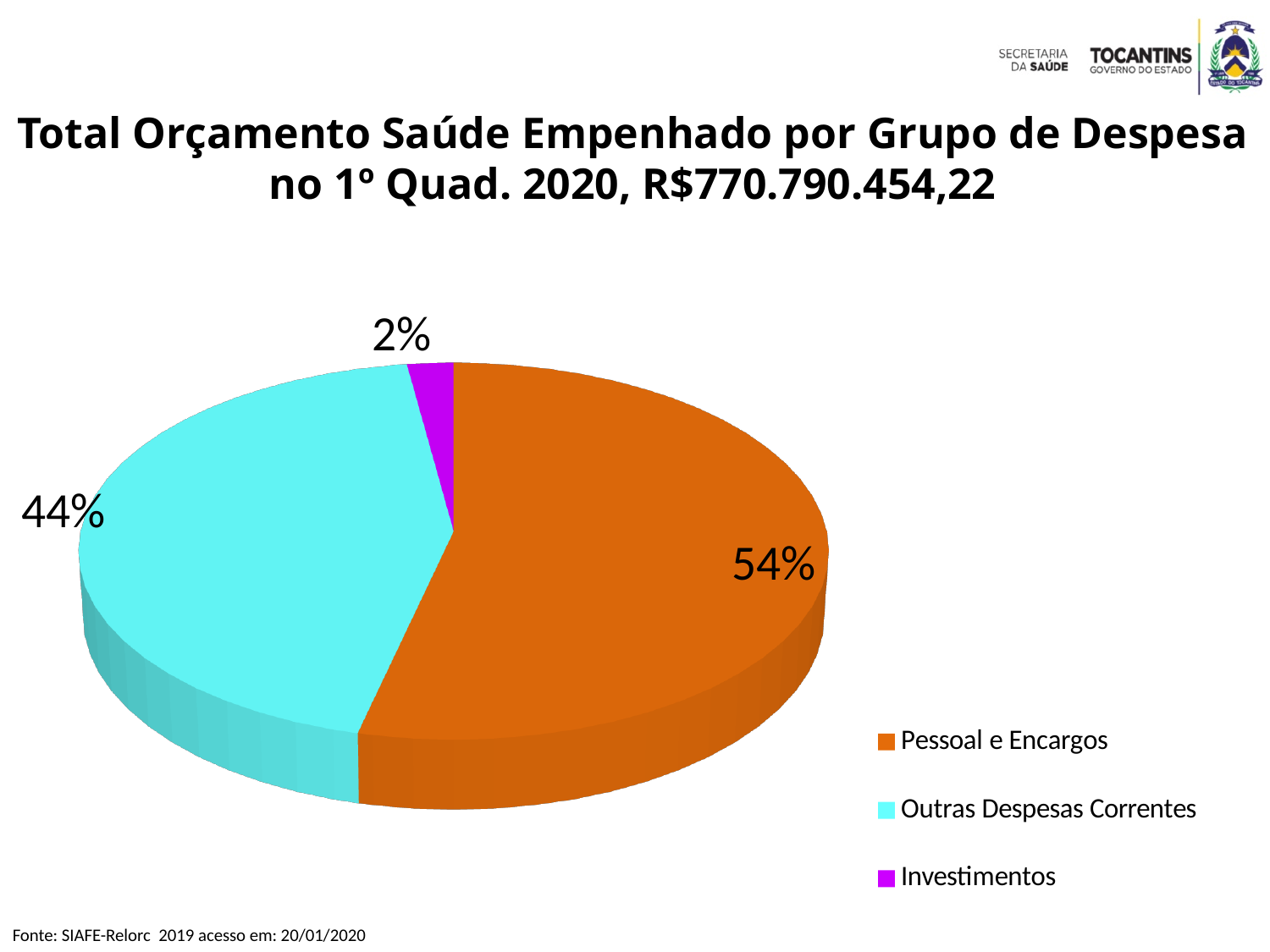
What is the difference in percentage points between Pessoal e Encargos and Outras Despesas Correntes? 10 What is the difference in percentage points between Outras Despesas Correntes and Investimentos? 42 What share of the pie does Pessoal e Encargos represent? 54% Which is larger, the share for Pessoal e Encargos or the share for Outras Despesas Correntes? Pessoal e Encargos How many slices does the pie chart have? 3 What colour is the slice for Outras Despesas Correntes? Cyan What kind of chart is shown on the slide? Pie chart Which expense group has the largest share of the pie? Pessoal e Encargos How many entries does the legend list? 3 What share of the pie does Outras Despesas Correntes represent? 44% Which expense group has the smallest share of the pie? Investimentos What share of the pie does Investimentos represent? 2%